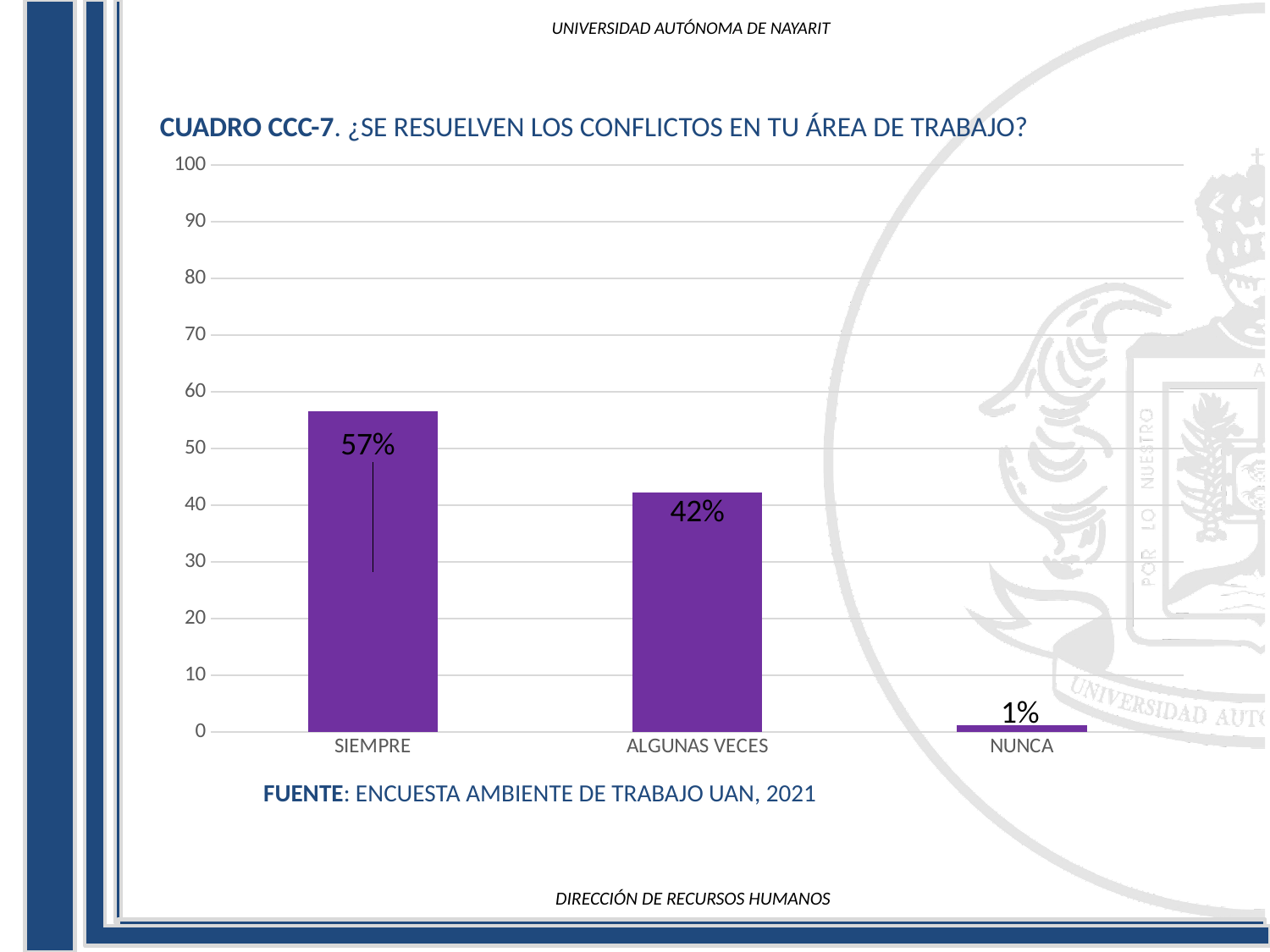
Is the value for ALGUNAS VECES greater or less than 50? less What is the value for ALGUNAS VECES? 42% How many categories are shown on the x axis? 3 Which is larger, the value for ALGUNAS VECES or the value for NUNCA? ALGUNAS VECES What kind of chart is shown on the slide? bar chart Which category has the highest value? SIEMPRE What is the difference between the values for SIEMPRE and ALGUNAS VECES? 15% Do the values rise or fall from left to right along the x axis? fall What is the value for SIEMPRE? 57% What is the source cited below the chart? ENCUESTA AMBIENTE DE TRABAJO UAN, 2021 What is the value for NUNCA? 1% Which category has the lowest value? NUNCA